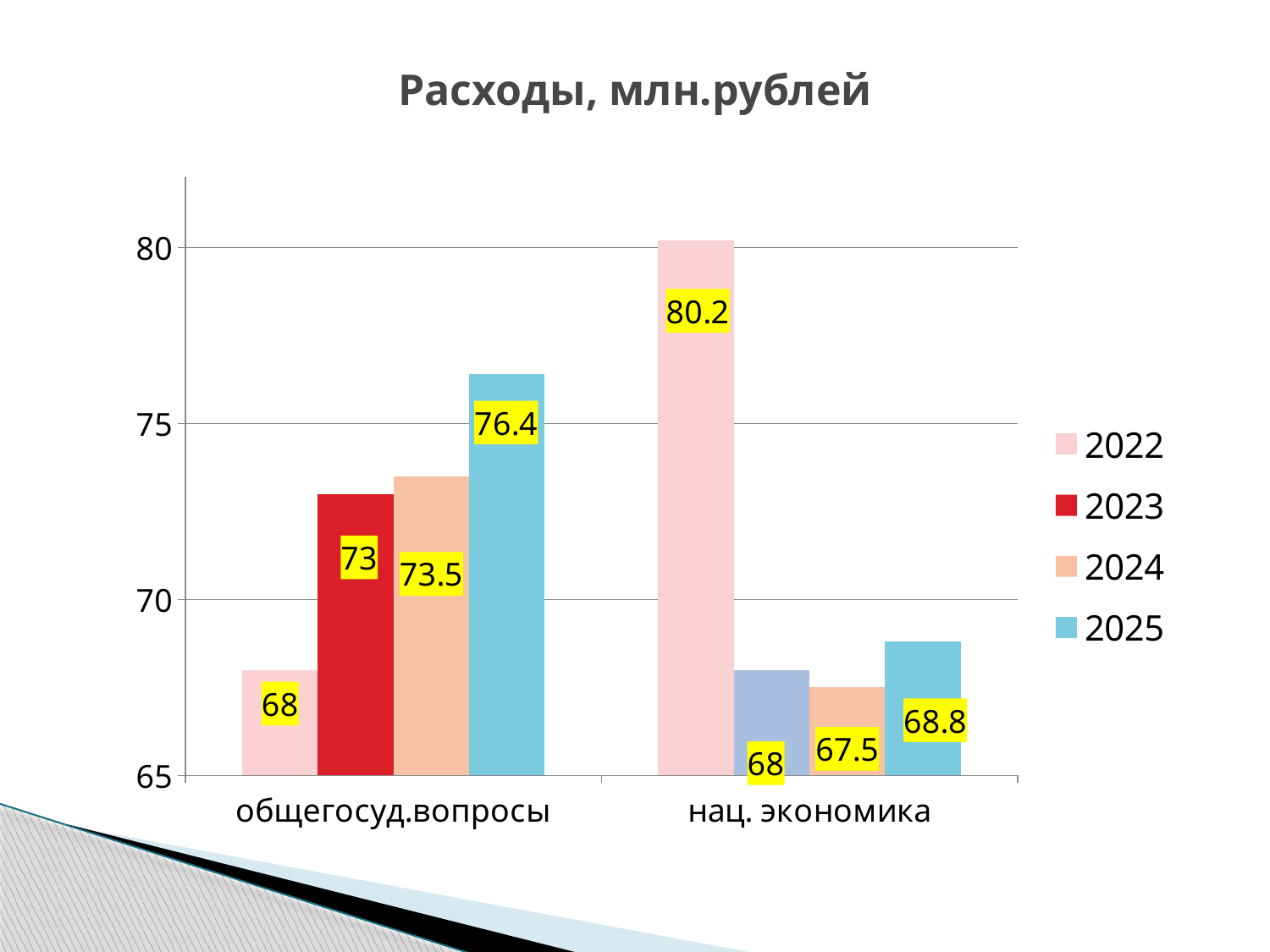
What kind of chart is shown on the slide? bar chart How many series does the legend list? 4 What is the title of the chart? Расходы, млн.рублей What is the value for 2024 in the нац. экономика category? 67.5 What is the value for 2025 in the общегосуд.вопросы category? 76.4 What is the value for 2022 in the нац. экономика category? 80.2 What is the difference between the 2025 and 2022 values in the общегосуд.вопросы category? 8.4 Which year has the lowest value in the нац. экономика category? 2024 Do the values for общегосуд.вопросы rise or fall from 2022 to 2025? rise Which year has the highest value in the общегосуд.вопросы category? 2025 Which is larger: the 2022 value for нац. экономика or the 2025 value for общегосуд.вопросы? 2022 value for нац. экономика What is the value for 2023 in the общегосуд.вопросы category? 73